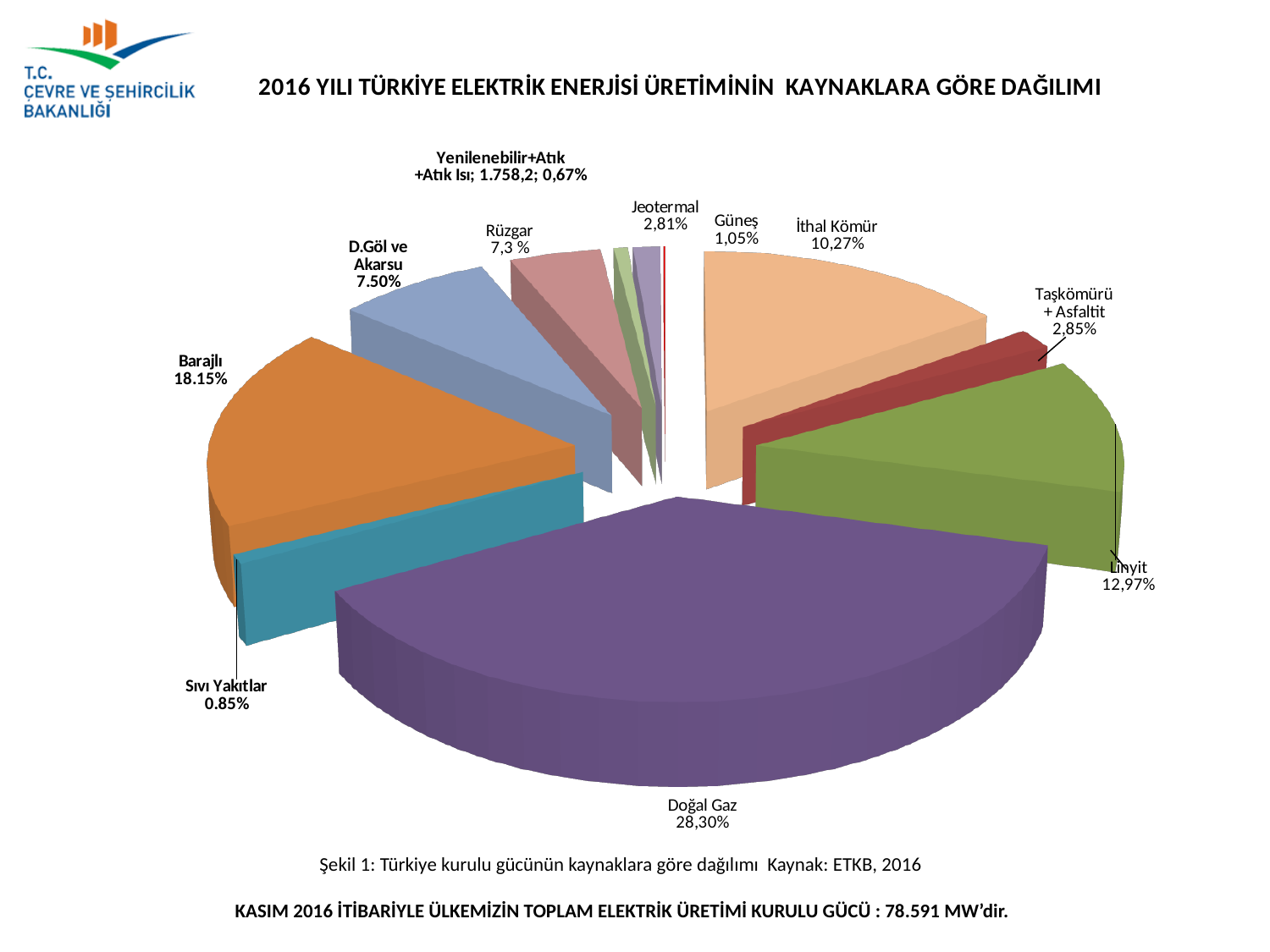
How many sources (slices) are shown in the pie chart? 11 What is the value shown for Barajlı? 18.15% What is the value shown for Jeotermal? 2,81% What share of the pie does Doğal Gaz have? 28,30% What is the difference between the shares of Doğal Gaz and İthal Kömür? 18,03% Which source has the largest share of the pie? Doğal Gaz What is the value shown for Linyit? 12,97% What is the value shown for İthal Kömür? 10,27% What kind of chart is shown on the slide? Pie chart Which has a larger share, Barajlı or Linyit? Barajlı What is the title of the chart? 2016 YILI TÜRKİYE ELEKTRİK ENERJİSİ ÜRETİMİNİN KAYNAKLARA GÖRE DAĞILIMI